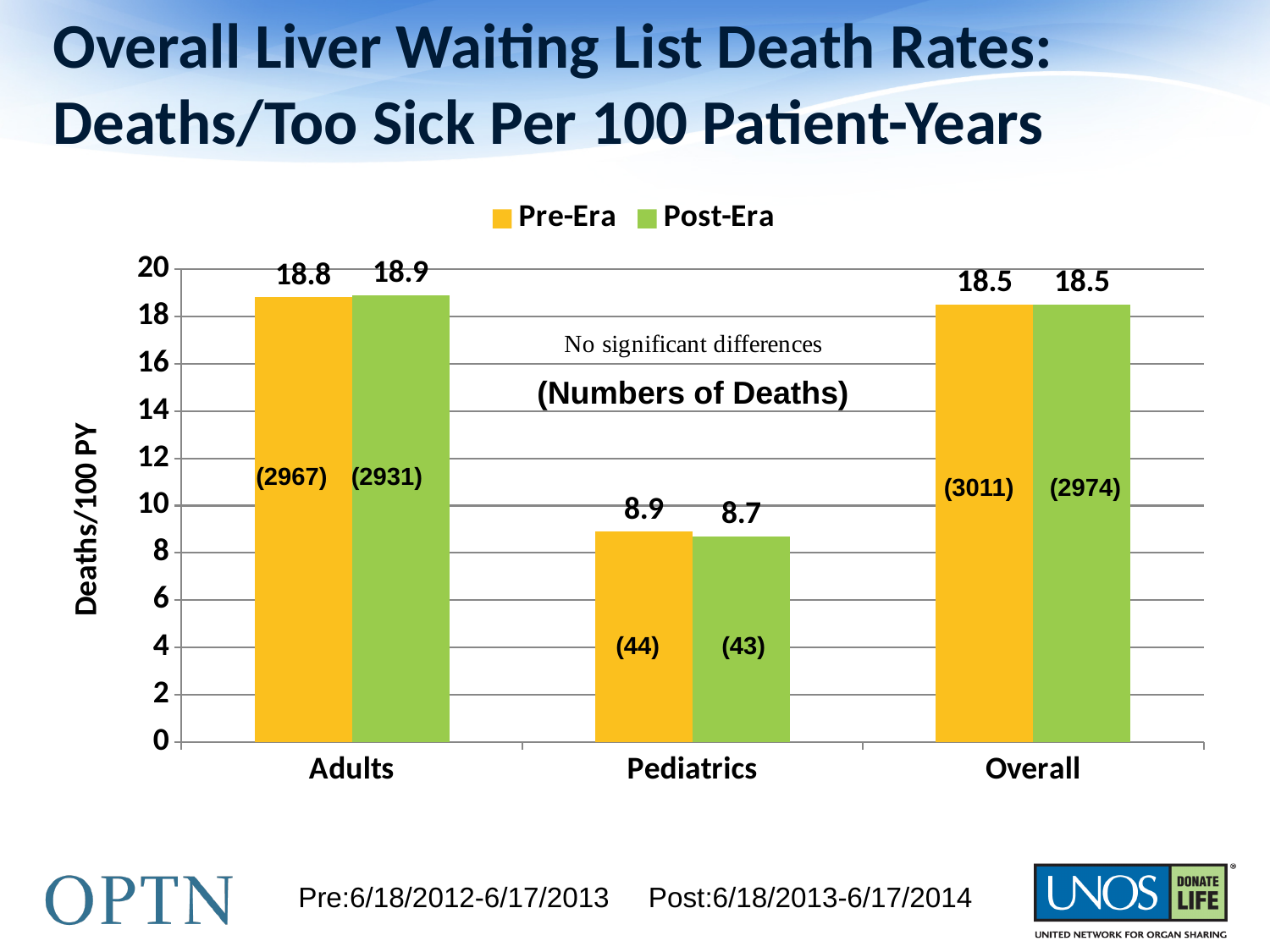
How many categories are shown on the x axis? 3 What is the Post-Era death rate for Overall? 18.5 What is the difference between the Adults and Pediatrics Pre-Era death rates? 9.9 What is the number of deaths shown for the Pre-Era Pediatrics bar? (44) Is the Pre-Era death rate for Adults greater or less than 18? greater What kind of chart is shown on the slide? Bar chart What is the Pre-Era death rate for Adults? 18.8 What is the difference between the Pre-Era and Post-Era death rates for Pediatrics? 0.2 How many series does the legend list? 2 Which category has the lowest Pre-Era death rate? Pediatrics Which category has the highest Post-Era death rate? Adults What is the Post-Era death rate for Pediatrics? 8.7